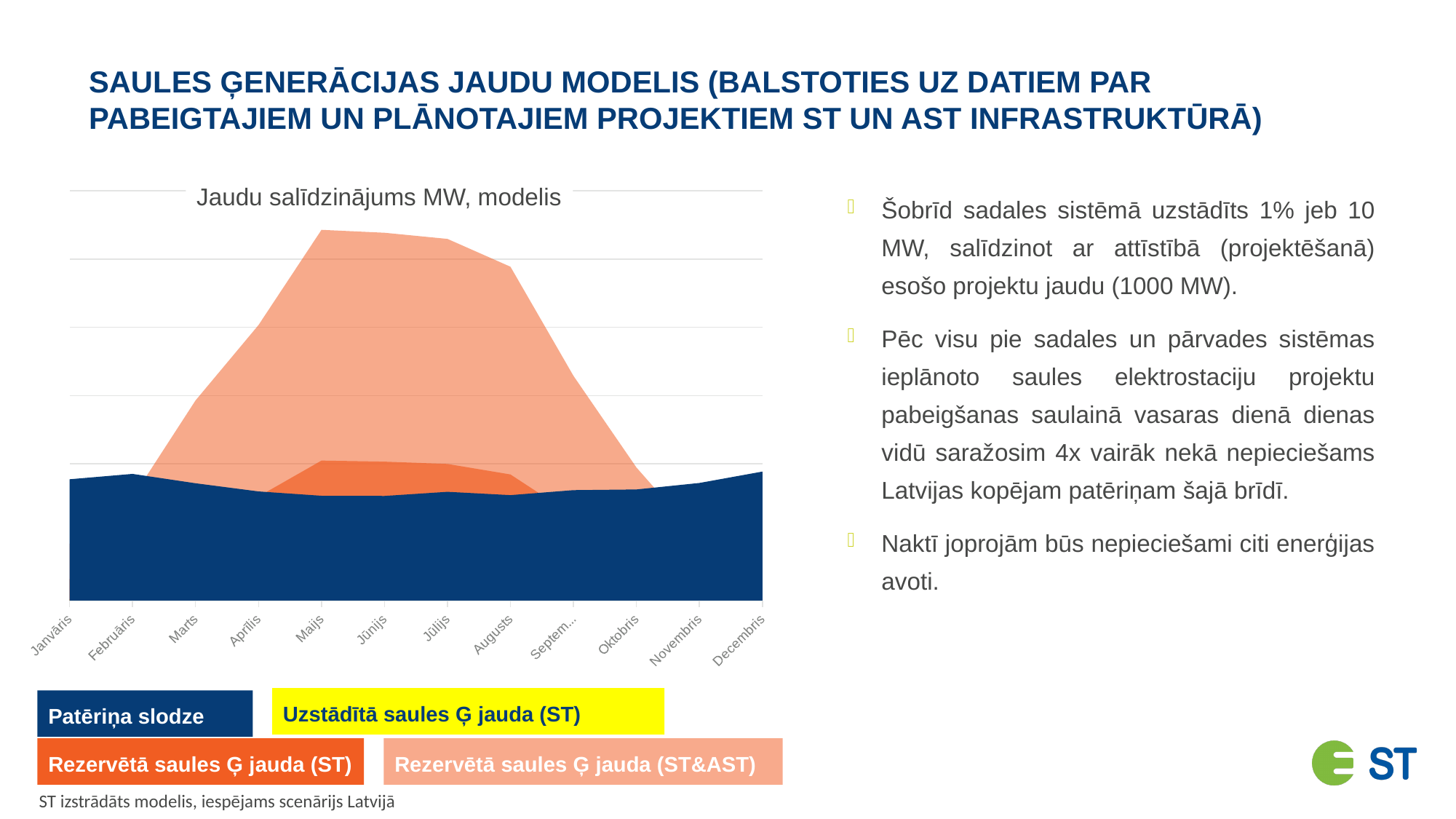
In which month does the 'Rezervētā saules Ģ jauda (ST)' series reach its highest value? Maijs How many series does the legend below the chart list? 4 In which month does the 'Rezervētā saules Ģ jauda (ST&AST)' series reach its highest value? Maijs Does the 'Rezervētā saules Ģ jauda (ST&AST)' series rise or fall from Jūlijs to Oktobris? Fall What kind of chart is shown on the slide? Area chart Which is larger for the 'Patēriņa slodze' series: the value in Decembris or the value in Jūlijs? Decembris Does the 'Rezervētā saules Ģ jauda (ST&AST)' series rise or fall from Janvāris to Maijs? Rise How many months are shown along the x axis of the chart? 12 Which legend entry is shown in dark blue? Patēriņa slodze What is the title of the chart? Jaudu salīdzinājums MW, modelis Which is larger for the 'Rezervētā saules Ģ jauda (ST&AST)' series: the value in Maijs or the value in Janvāris? Maijs Which is larger for the 'Rezervētā saules Ģ jauda (ST&AST)' series: the value in Jūnijs or the value in Novembris? Jūnijs